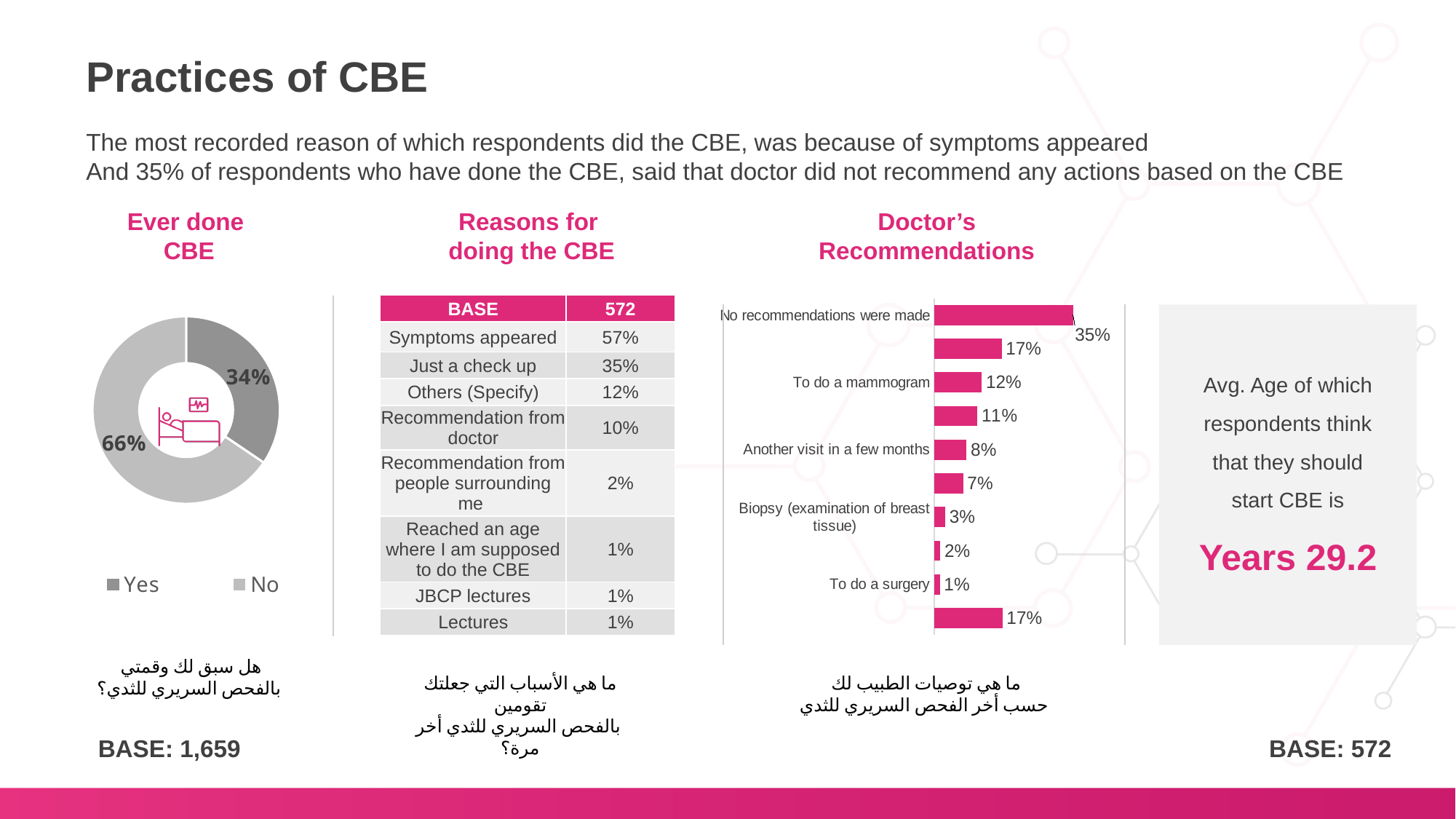
In the Doctor's Recommendations chart, which labelled category has the highest value? No recommendations were made In the Doctor's Recommendations chart, what is the value for To do a mammogram? 12% In the Ever done CBE chart, what percentage of respondents answered Yes? 34% What kind of chart is the Ever done CBE chart? Pie chart (donut) In the Doctor's Recommendations chart, what is the value for Biopsy (examination of breast tissue)? 3% What kind of chart is the Doctor's Recommendations chart? Bar chart How many entries does the legend of the Ever done CBE chart list? 2 In the Ever done CBE chart, which slice is larger, Yes or No? No In the Ever done CBE chart, what is the difference between the No and Yes shares? 32% In the Ever done CBE chart, what percentage of respondents answered No? 66% In the Doctor's Recommendations chart, what is the value for Another visit in a few months? 8% In the Doctor's Recommendations chart, what is the value for No recommendations were made? 35%